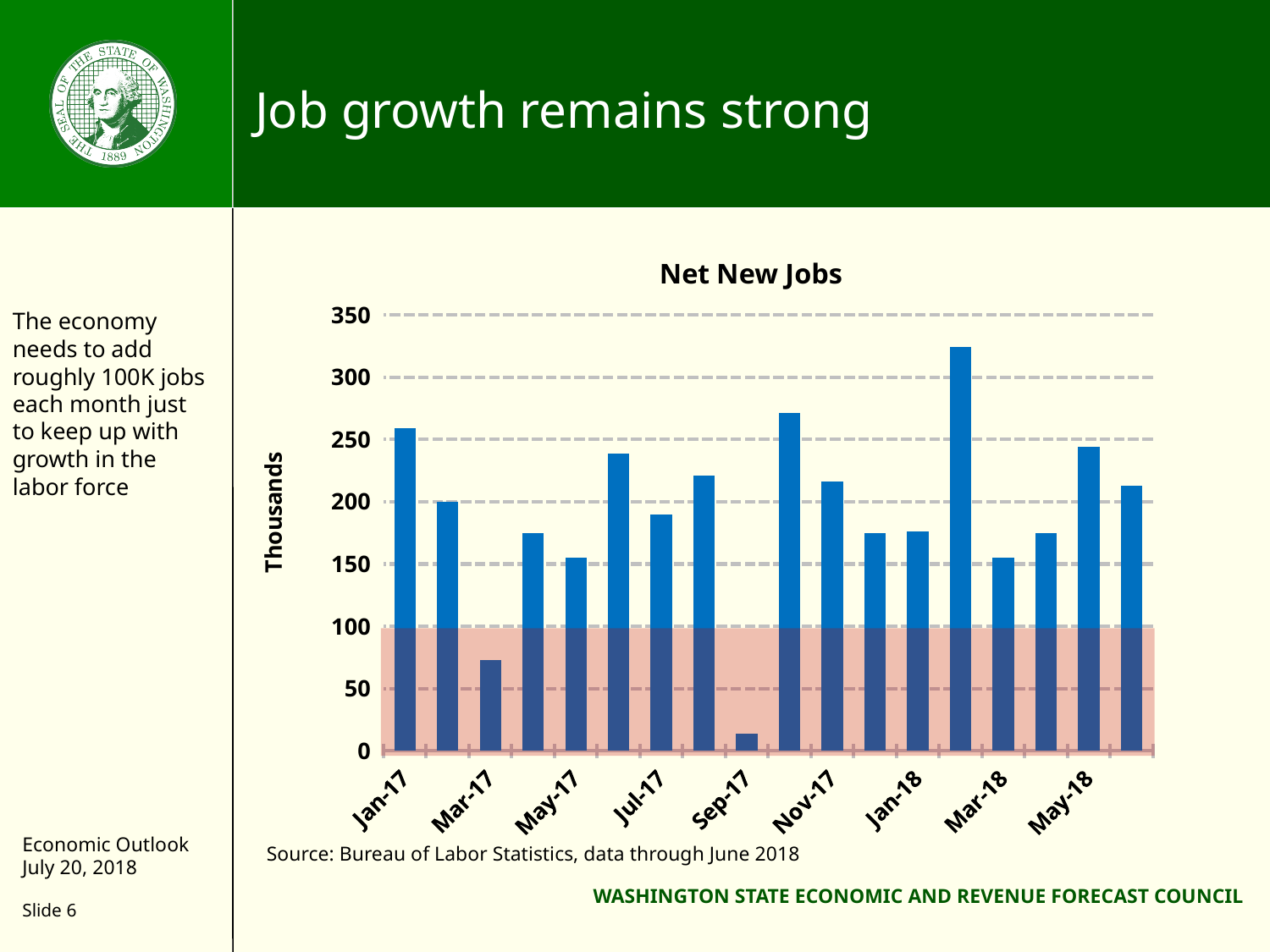
Which is larger, the value for Jan-17 or the value for Mar-17? Jan-17 Is the value for Jan-17 greater or less than 250? greater What kind of chart is shown on the slide? bar chart How many monthly bars are plotted in the chart? 18 Is the value for Sep-17 greater or less than 50? less What is the label on the vertical axis of the chart? Thousands Which is larger, the value for Nov-17 or the value for Jul-17? Nov-17 Is the value for May-18 greater or less than 200? greater Which labeled month has the lowest value in the chart? Sep-17 What is the title of the chart? Net New Jobs